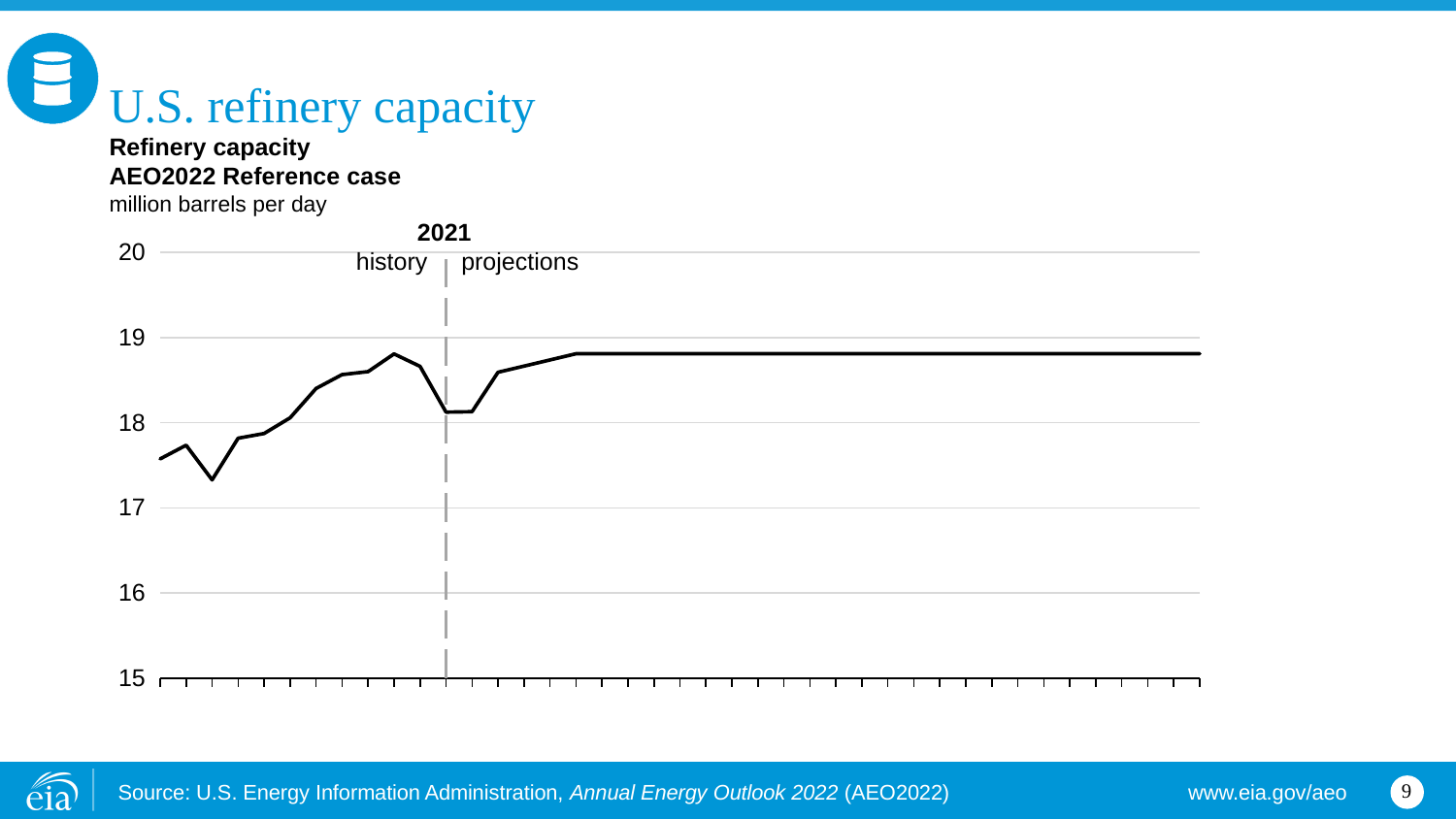
Which year marks the boundary between history and projections on the chart? 2021 Is the lowest refinery capacity value in the history period greater or less than 18 million barrels per day? less Is the lowest refinery capacity value in the history period greater or less than 17 million barrels per day? greater What is the title of the chart? Refinery capacity AEO2022 Reference case How many data series are plotted on the chart? 1 How does refinery capacity change over most of the projection period after the initial rise? stays flat Is refinery capacity at 2021 higher or lower than the projected capacity at the end of the projection period? lower Is the projected refinery capacity at the end of the projection period greater or less than 19 million barrels per day? less In what units is refinery capacity plotted on the chart? million barrels per day What type of chart is shown on the slide? line chart